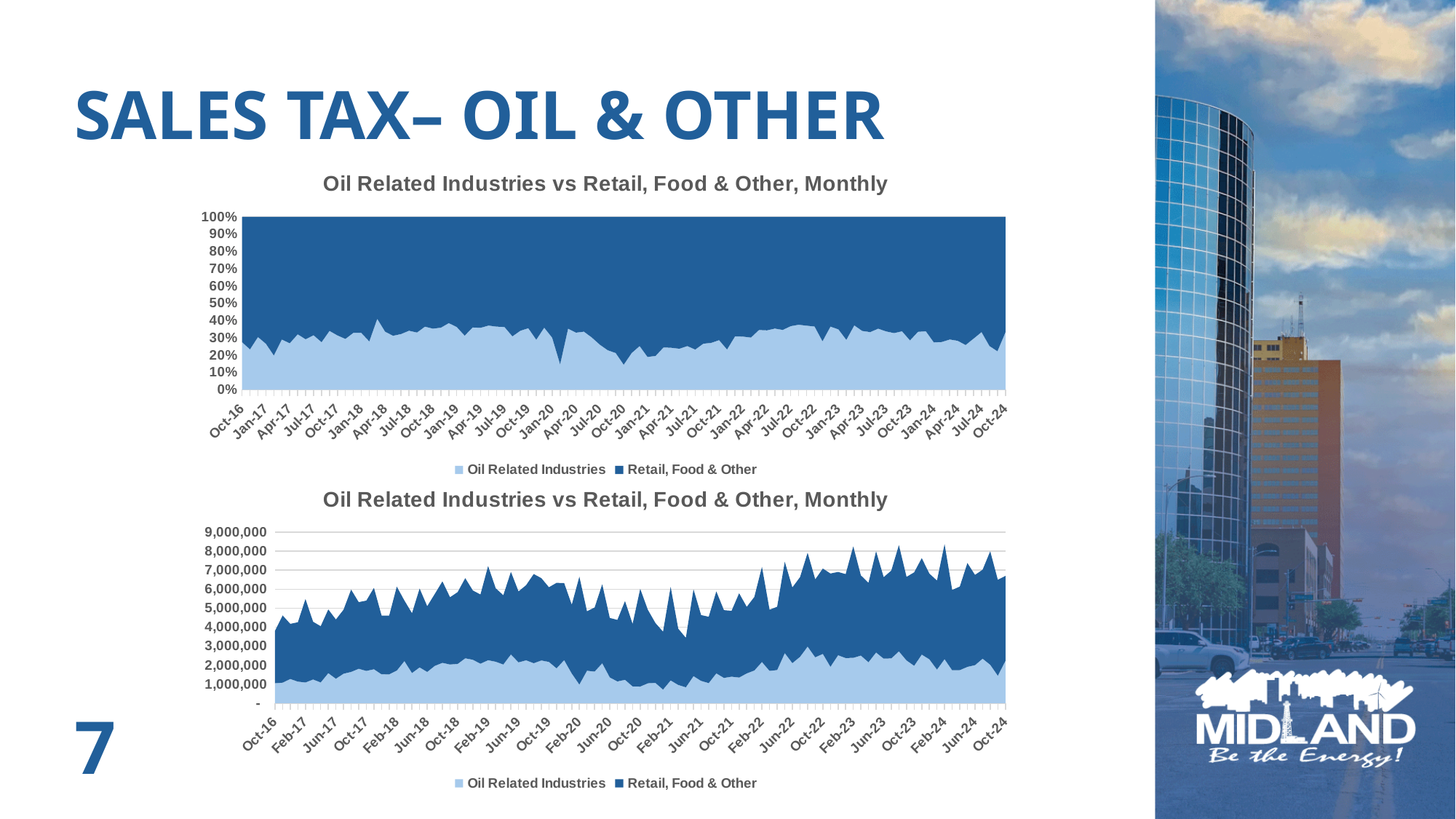
What kind of chart is the bottom chart on the slide? Stacked area chart In the bottom chart, which series is shown in the lighter blue colour? Oil Related Industries In the top chart, is the share for Retail, Food & Other at Oct-24 greater or less than 50%? greater How many series does the legend of the bottom chart list? 2 In the bottom chart, is the value for Oil Related Industries at Oct-16 greater or less than 2,000,000? less In the bottom chart, does the combined total generally rise or fall between Feb-21 and Feb-23? rise In the top chart, is the share for Oil Related Industries at Oct-16 greater or less than 50%? less What kind of chart is the top chart on the slide? Stacked area chart What is the title of the top chart? Oil Related Industries vs Retail, Food & Other, Monthly How many series does the legend of the top chart list? 2